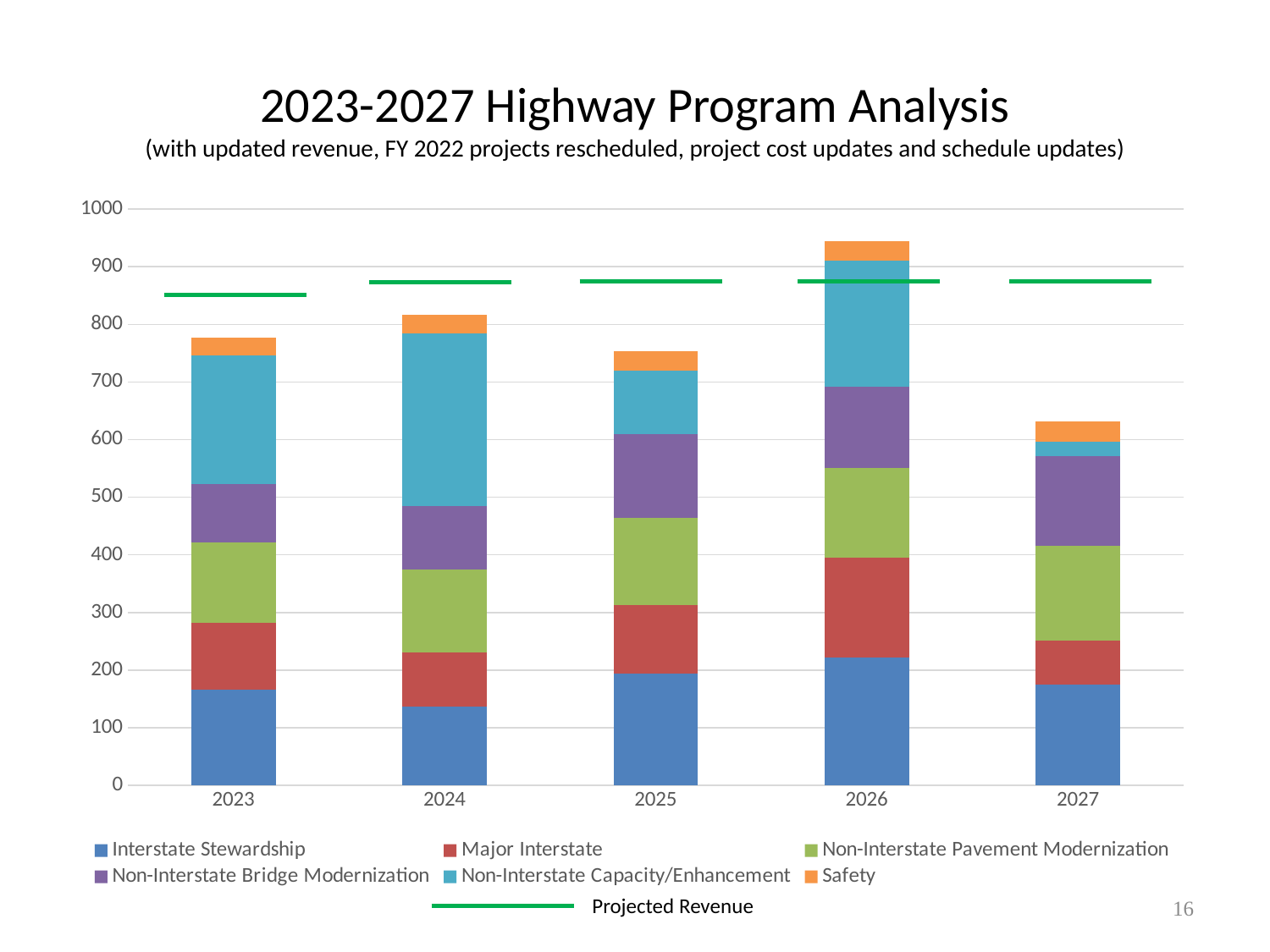
Is the total stacked bar for 2026 greater or less than 900? greater Which year has the larger total stacked bar, 2024 or 2025? 2024 Which year has the highest total stacked bar? 2026 How many years are shown on the x axis of the chart? 5 Which year has the lowest total stacked bar? 2027 What colour represents the Safety series in the chart? Orange Is the total stacked bar for 2023 greater or less than 700? greater Is the total stacked bar for 2025 greater or less than 800? less What does the green horizontal line in the chart represent? Projected Revenue How many stacked series does the main legend list (not counting the Projected Revenue line)? 6 What kind of chart is shown on the slide? Stacked bar chart